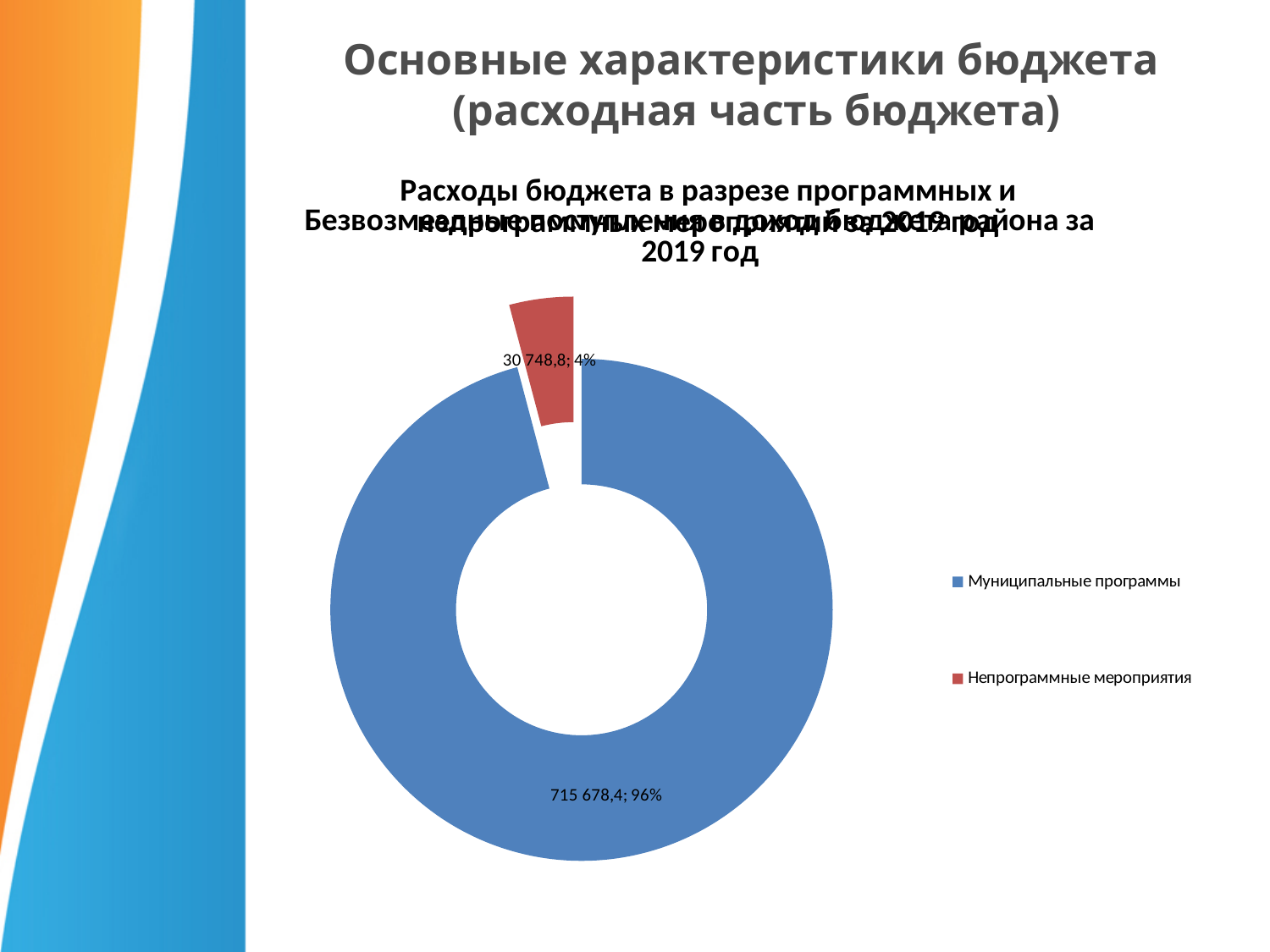
Which category has the largest share of the chart? Муниципальные программы Which is larger, Муниципальные программы or Непрограммные мероприятия? Муниципальные программы What percentage share does Муниципальные программы have? 96% What value is shown for Муниципальные программы? 715 678,4 What colour is the slice for Непрограммные мероприятия? Red What percentage share does Непрограммные мероприятия have? 4% Which category has the smallest share of the chart? Непрограммные мероприятия How many categories are shown in the chart? 2 What is the difference in percentage points between the shares of Муниципальные программы and Непрограммные мероприятия? 92 What kind of chart is shown on the slide? Doughnut (pie) chart How many entries does the legend list? 2 What value is shown for Непрограммные мероприятия? 30 748,8